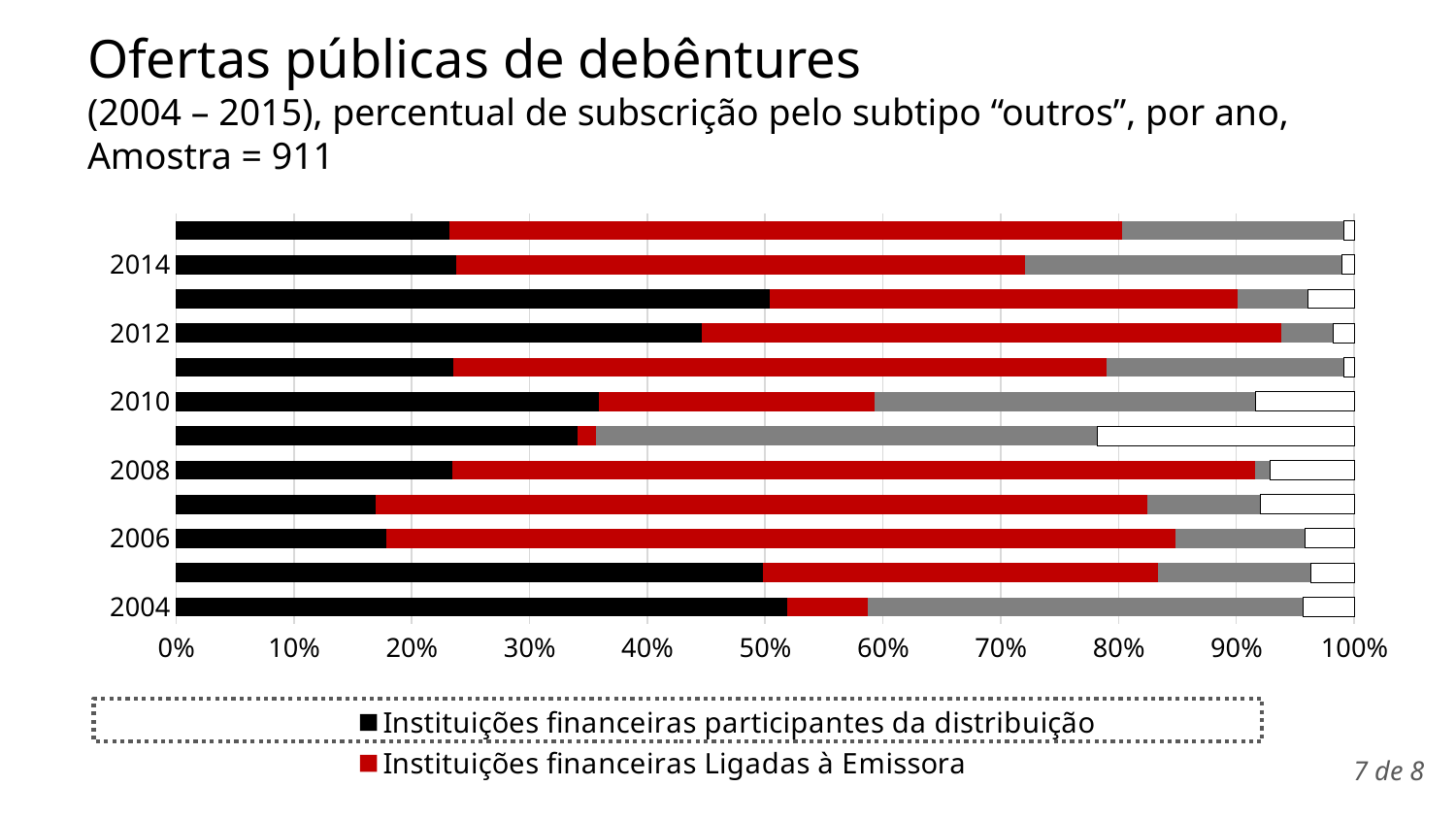
Is the value for 'Instituições financeiras participantes da distribuição' in 2012 greater or less than 40%? greater How many series does the legend list? 2 Is the value for 'Instituições financeiras participantes da distribuição' in 2007 greater or less than 20%? less What kind of chart is shown on the slide? stacked bar chart Which year has the larger share for 'Instituições financeiras participantes da distribuição', 2004 or 2007? 2004 Which year has the smallest share for 'Instituições financeiras Ligadas à Emissora'? 2009 Which year has the larger share for 'Instituições financeiras Ligadas à Emissora', 2008 or 2009? 2008 Which colour represents 'Instituições financeiras Ligadas à Emissora' in the chart? red Is the value for 'Instituições financeiras participantes da distribuição' in 2010 greater or less than 30%? greater How many years (bars) are plotted in the chart? 12